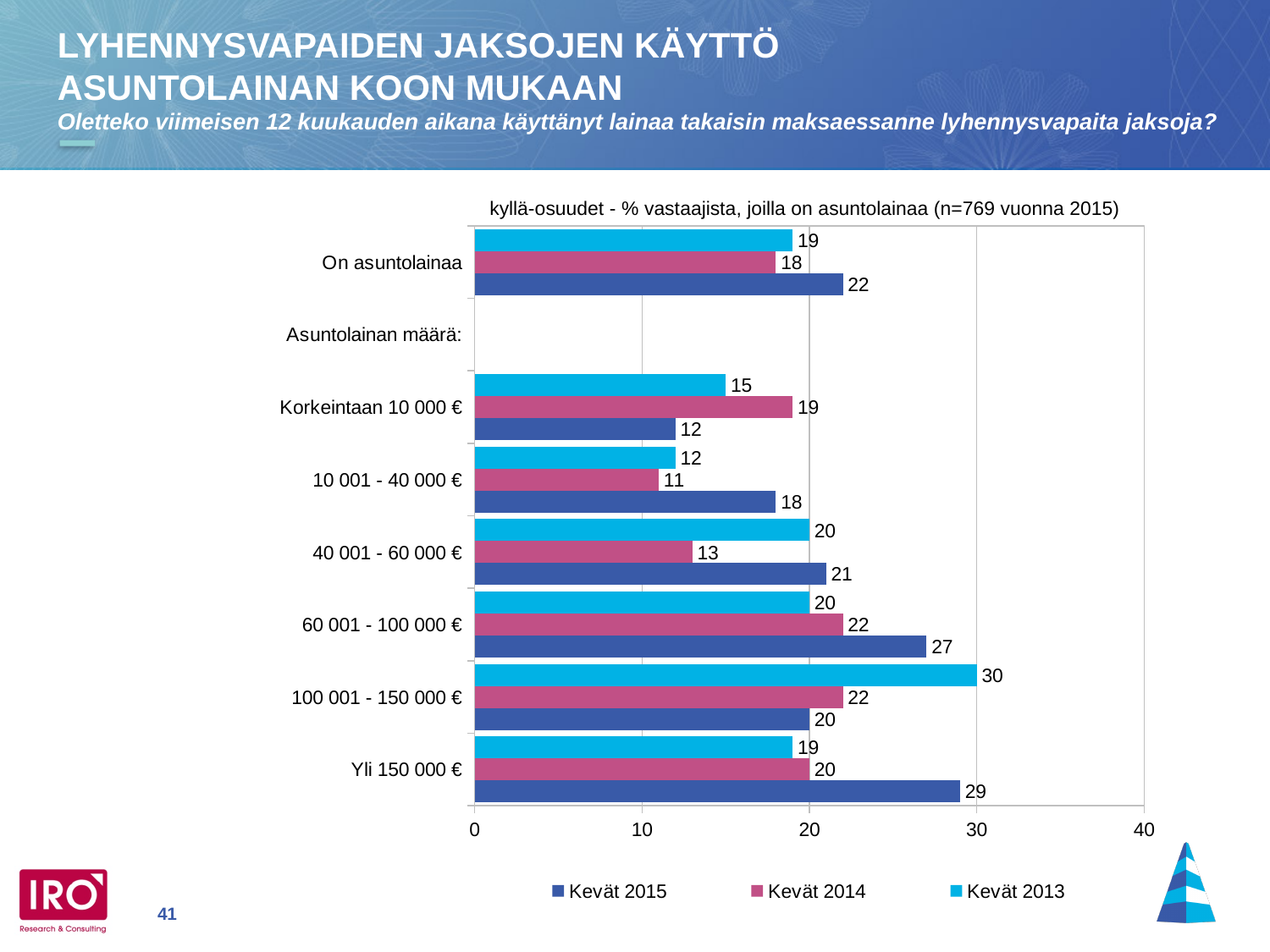
What is the Kevät 2015 value for On asuntolainaa? 22 What are the three legend entries of the chart? Kevät 2015, Kevät 2014, Kevät 2013 How many series does the legend list? 3 What is the Kevät 2013 value for 100 001 - 150 000 €? 30 Which category has the highest Kevät 2015 value? Yli 150 000 € For 100 001 - 150 000 €, which is larger: the Kevät 2013 value or the Kevät 2015 value? Kevät 2013 What is the Kevät 2014 value for 40 001 - 60 000 €? 13 What is the Kevät 2015 value for Yli 150 000 €? 29 What kind of chart is shown on the slide? Bar chart Which category has the lowest Kevät 2014 value? 10 001 - 40 000 € Which category has the highest Kevät 2013 value? 100 001 - 150 000 € What is the difference between the Kevät 2015 and Kevät 2014 values for 60 001 - 100 000 €? 5